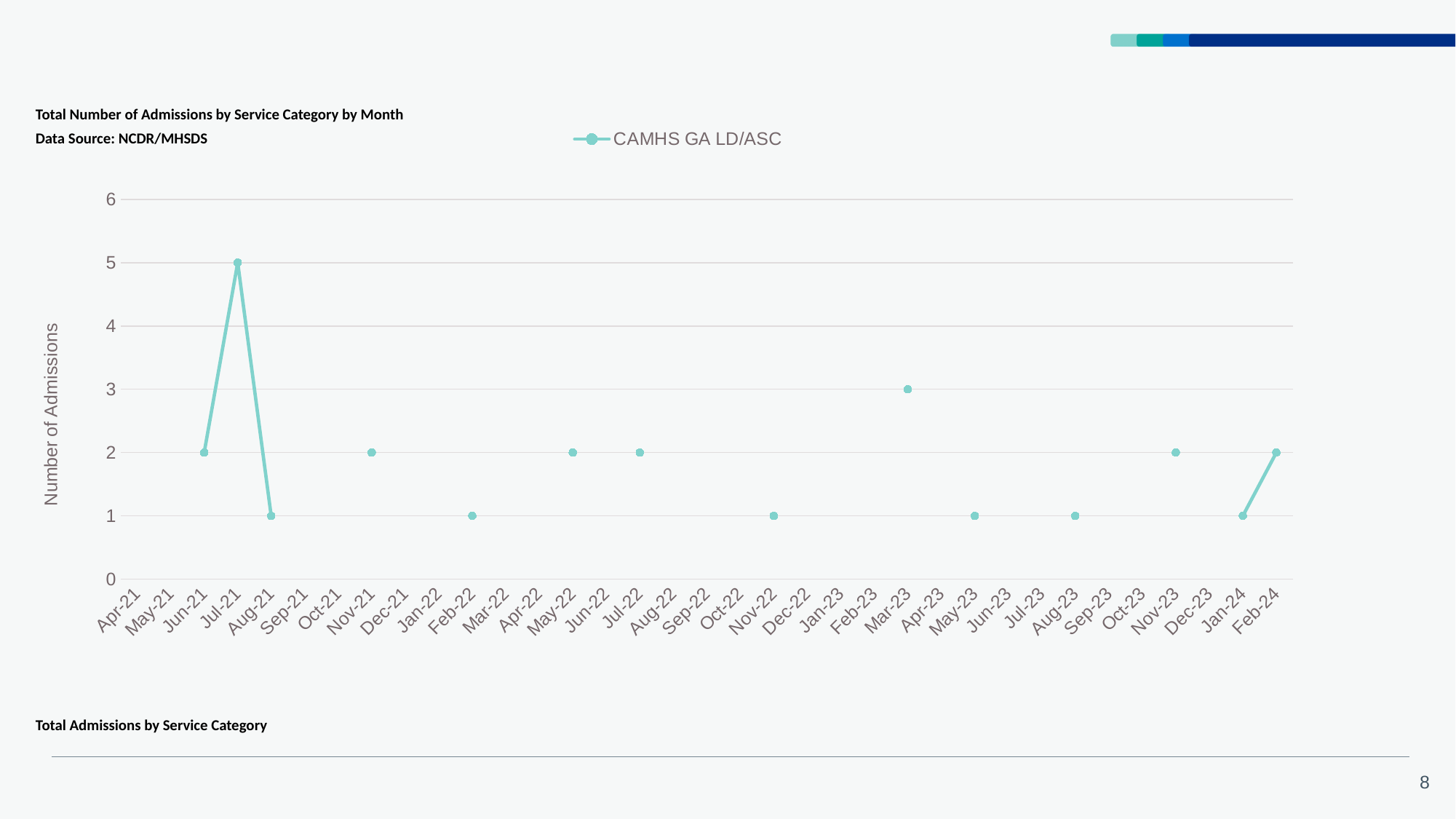
Is the value for Jul-21 greater or less than 4? greater What is the number of admissions for CAMHS GA LD/ASC in Mar-23? 3 What is the title of the y axis? Number of Admissions What is the number of admissions for CAMHS GA LD/ASC in Jul-21? 5 What is the name of the series shown in the legend? CAMHS GA LD/ASC What is the number of admissions for CAMHS GA LD/ASC in Feb-24? 2 How many series does the legend list? 1 Which month has the highest number of admissions for CAMHS GA LD/ASC? Jul-21 How many months are shown on the x axis? 35 Which month has more admissions, Mar-23 or Nov-23? Mar-23 What is the difference between the number of admissions in Jul-21 and Aug-21? 4 What kind of chart is shown on the slide? line chart